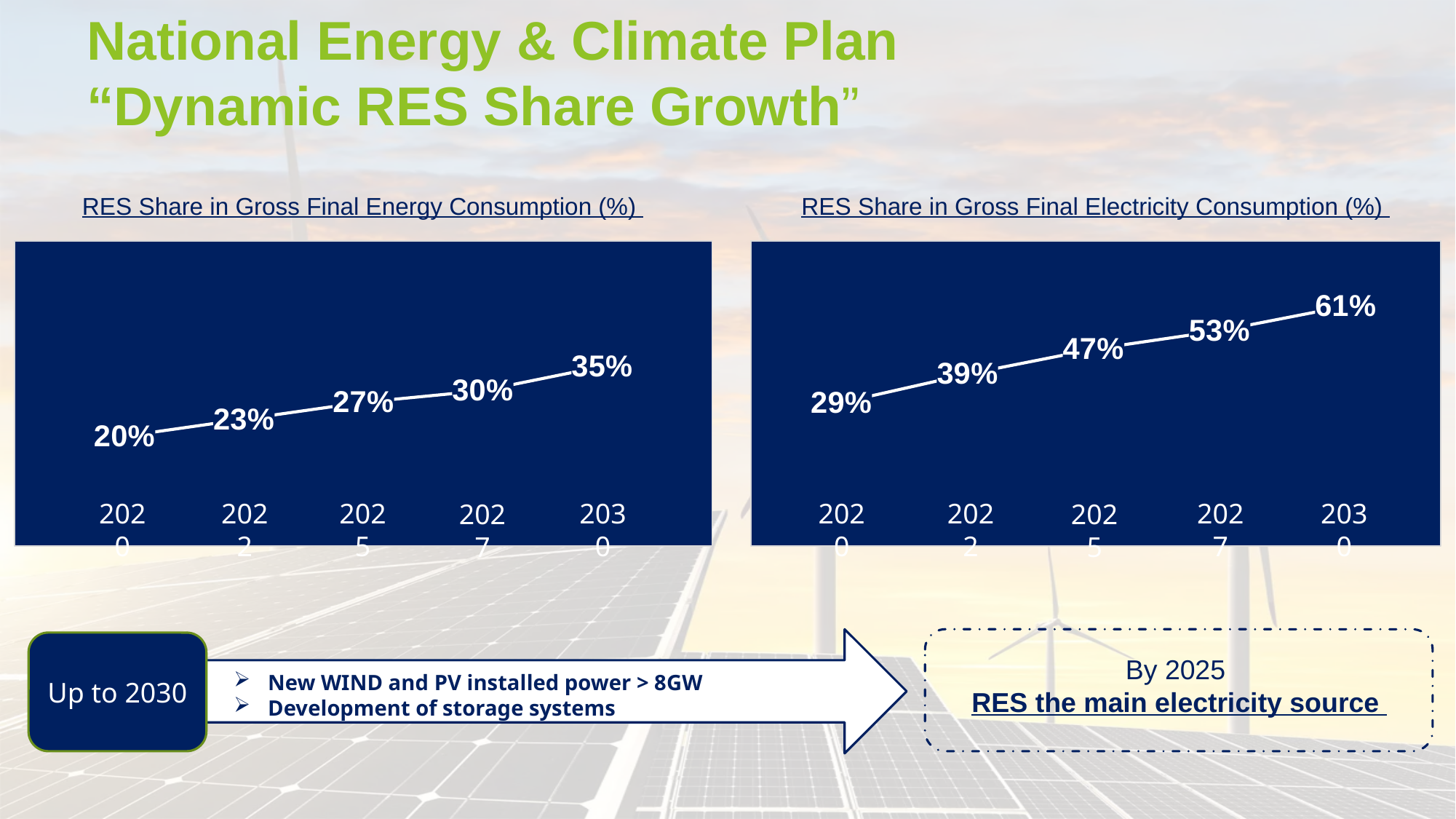
In the 'RES Share in Gross Final Electricity Consumption (%)' chart, which year has the lowest value? 2020 In the 'RES Share in Gross Final Electricity Consumption (%)' chart, what is the difference between the 2030 value and the 2020 value? 32% In the 'RES Share in Gross Final Electricity Consumption (%)' chart, do the values rise or fall from 2020 to 2030? Rise In the 'RES Share in Gross Final Energy Consumption (%)' chart, what is the difference between the 2030 value and the 2027 value? 5% In the 'RES Share in Gross Final Energy Consumption (%)' chart, which year has the highest value? 2030 How many data points are plotted in the 'RES Share in Gross Final Electricity Consumption (%)' chart? 5 What is the title of the chart on the right side of the slide? RES Share in Gross Final Electricity Consumption (%) In the 'RES Share in Gross Final Energy Consumption (%)' chart, what is the value for 2025? 27% What kind of chart is the 'RES Share in Gross Final Energy Consumption (%)' chart? Line chart Which is larger: the 2025 value in the 'RES Share in Gross Final Energy Consumption (%)' chart or the 2020 value in the 'RES Share in Gross Final Electricity Consumption (%)' chart? The 2020 value in the Electricity Consumption chart (29%) In the 'RES Share in Gross Final Energy Consumption (%)' chart, what is the value for 2020? 20% In the 'RES Share in Gross Final Electricity Consumption (%)' chart, what is the value for 2027? 53%